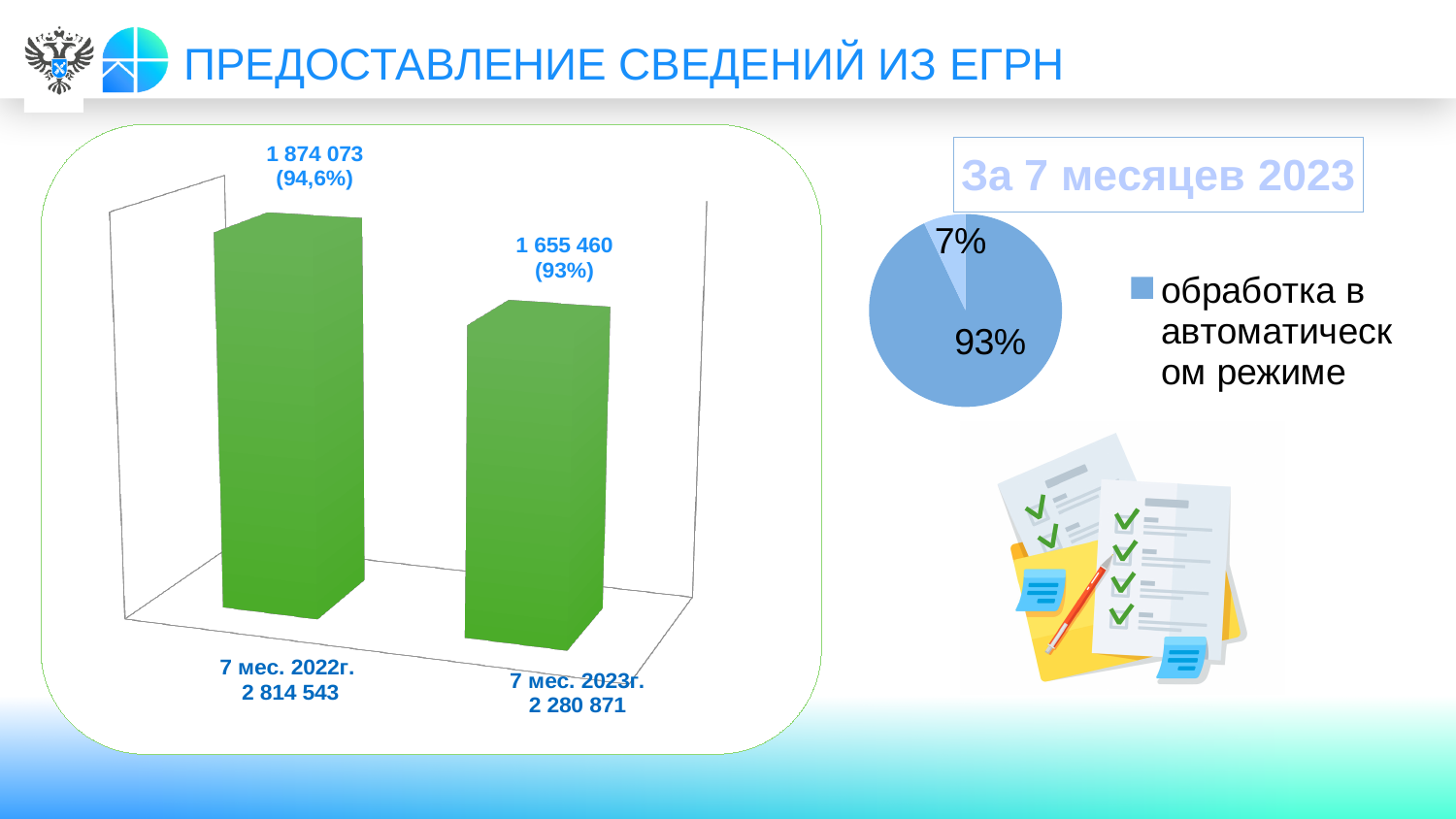
On the bar chart on the left, do the values rise or fall from 7 мес. 2022г. to 7 мес. 2023г.? Fall On the bar chart on the left, which category has the taller bar? 7 мес. 2022г. What kind of chart is shown on the right of the slide under 'За 7 месяцев 2023'? Pie chart On the bar chart on the left, which category has the shorter bar? 7 мес. 2023г. On the bar chart on the left, what is the data label for the bar for 7 мес. 2023г.? 1 655 460 (93%) On the bar chart on the left, what is the difference between the values 1 874 073 and 1 655 460? 218 613 On the bar chart on the left, what number is printed under the category label 7 мес. 2022г.? 2 814 543 On the pie chart titled 'За 7 месяцев 2023', what share does the smaller slice have? 7% On the pie chart titled 'За 7 месяцев 2023', what share does the larger slice have? 93% What kind of chart is shown on the left of the slide? Bar chart On the bar chart on the left, how many bars are plotted? 2 On the bar chart on the left, what is the data label for the bar for 7 мес. 2022г.? 1 874 073 (94,6%)